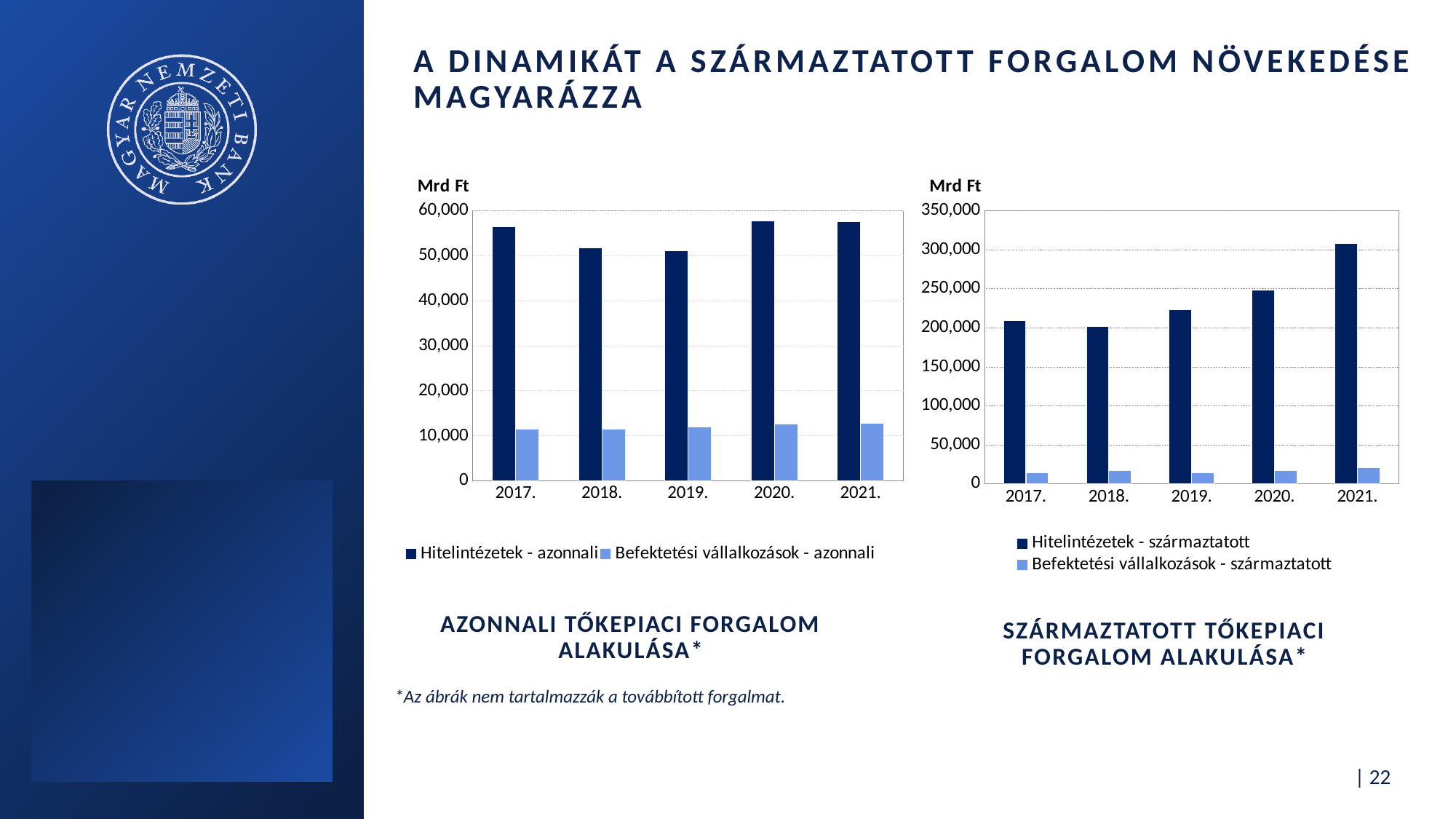
How many years are shown on the x axis of the 'Származtatott tőkepiaci forgalom alakulása' chart on the right? 5 What is the second legend entry of the right chart, 'Származtatott tőkepiaci forgalom alakulása'? Befektetési vállalkozások - származtatott In the right chart, 'Származtatott tőkepiaci forgalom alakulása', which year has the highest value for Hitelintézetek - származtatott? 2021. In the right chart, 'Származtatott tőkepiaci forgalom alakulása', is the value for Hitelintézetek - származtatott in 2018 greater or less than 250,000? less In the right chart, 'Származtatott tőkepiaci forgalom alakulása', is the value for Hitelintézetek - származtatott in 2021 greater or less than 300,000? greater In the left chart, 'Azonnali tőkepiaci forgalom alakulása', is the value for Befektetési vállalkozások - azonnali in 2021 greater or less than 20,000? less What kind of chart is the 'Azonnali tőkepiaci forgalom alakulása' chart on the left? bar chart In the right chart, 'Származtatott tőkepiaci forgalom alakulása', does the value for Hitelintézetek - származtatott rise or fall from 2018 to 2021? rise How many series does the legend of the left chart, 'Azonnali tőkepiaci forgalom alakulása', list? 2 What unit is shown above the y axis of both charts? Mrd Ft In the left chart, 'Azonnali tőkepiaci forgalom alakulása', which is larger for Hitelintézetek - azonnali: 2017 or 2019? 2017.